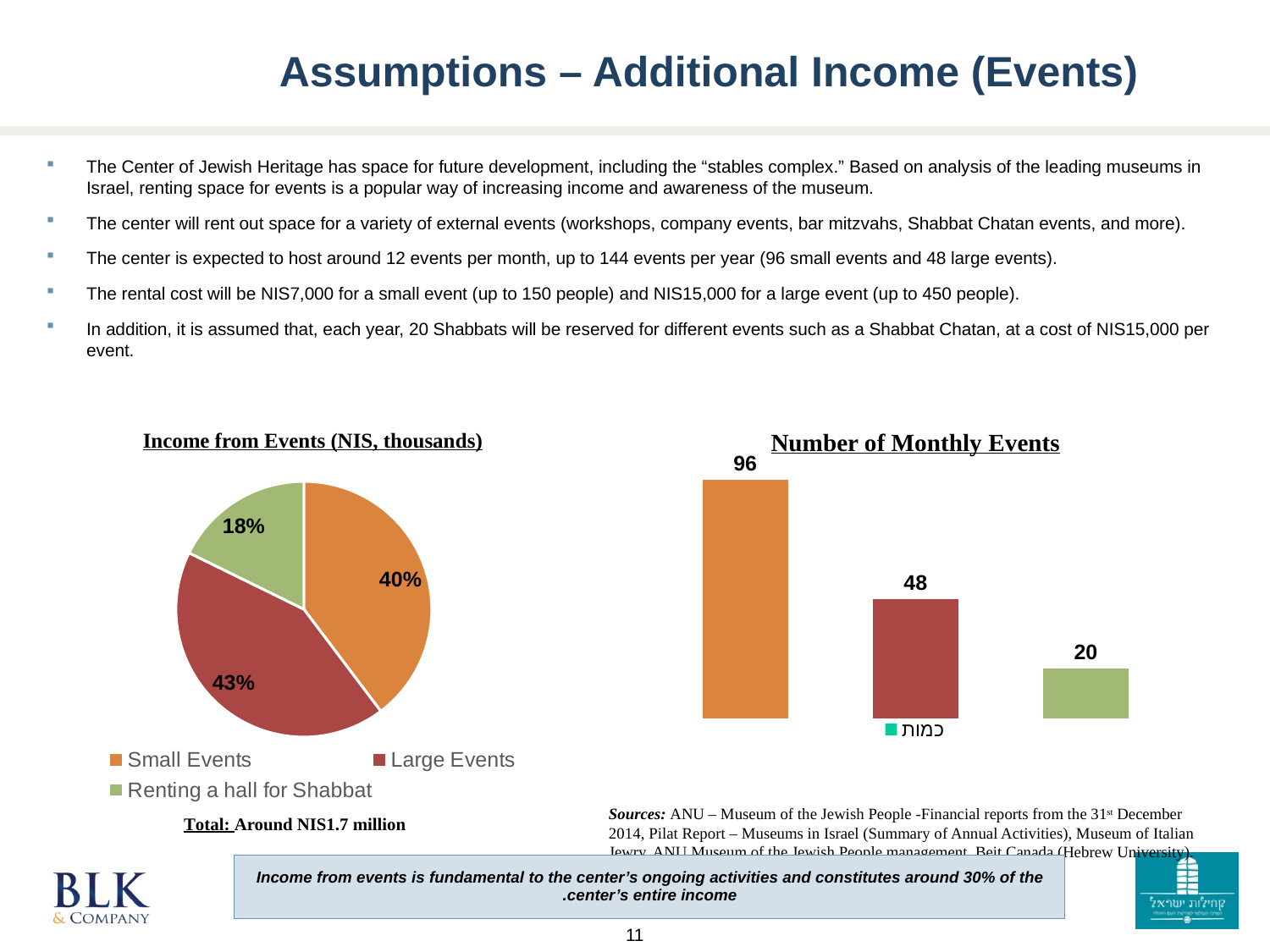
On the 'Income from Events (NIS, thousands)' chart, what share of income comes from Large Events? 43% On the 'Income from Events (NIS, thousands)' chart, which category has the smallest share? Renting a hall for Shabbat On the 'Income from Events (NIS, thousands)' chart, what share of income comes from Renting a hall for Shabbat? 18% On the 'Income from Events (NIS, thousands)' chart, how many categories does the legend list? 3 On the 'Number of Monthly Events' chart, what is the value of the first (leftmost) bar? 96 On the 'Income from Events (NIS, thousands)' chart, which category has the largest share? Large Events On the 'Number of Monthly Events' chart, what is the value of the third (rightmost) bar? 20 On the 'Number of Monthly Events' chart, do the bar values rise or fall from left to right? Fall On the 'Income from Events (NIS, thousands)' chart, what share of income comes from Small Events? 40% On the 'Number of Monthly Events' chart, what is the difference between the first bar (96) and the second bar (48)? 48 What kind of chart is 'Number of Monthly Events'? Bar chart What kind of chart is 'Income from Events (NIS, thousands)'? Pie chart